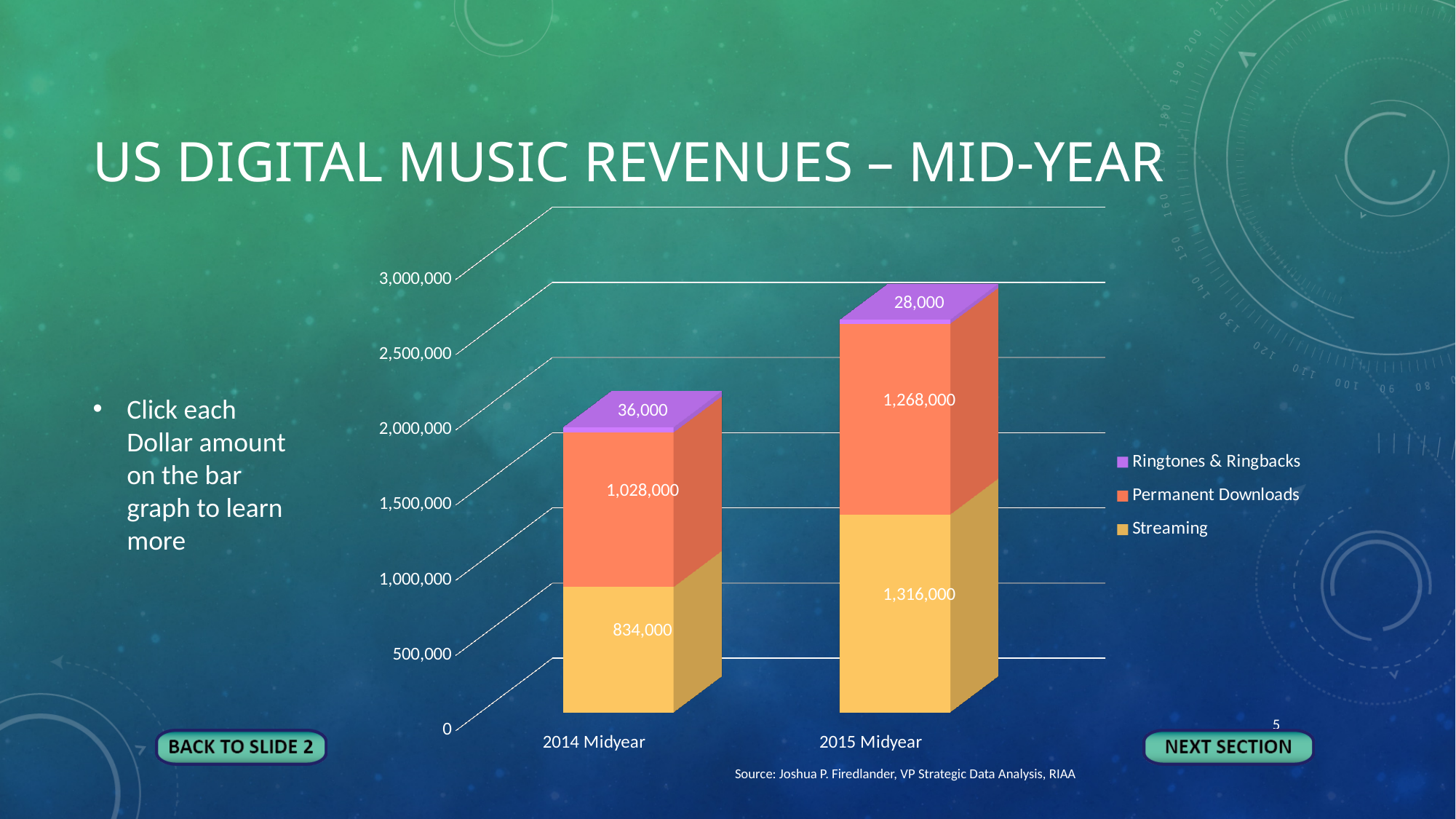
Which category has the higher Streaming value, 2014 Midyear or 2015 Midyear? 2015 Midyear What is the Streaming value for 2015 Midyear? 1,316,000 What is the difference between the Permanent Downloads values for 2015 Midyear and 2014 Midyear? 240,000 What is the total of the stacked bar for 2014 Midyear? 1,898,000 What is the Permanent Downloads value for 2015 Midyear? 1,268,000 What is the difference between the Streaming values for 2015 Midyear and 2014 Midyear? 482,000 What is the total of the stacked bar for 2015 Midyear? 2,612,000 What is the Ringtones & Ringbacks value for 2014 Midyear? 36,000 How many series does the legend list? 3 Which category has the lower Ringtones & Ringbacks value? 2015 Midyear What is the Streaming value for 2014 Midyear? 834,000 What kind of chart is shown on the slide? Stacked bar chart